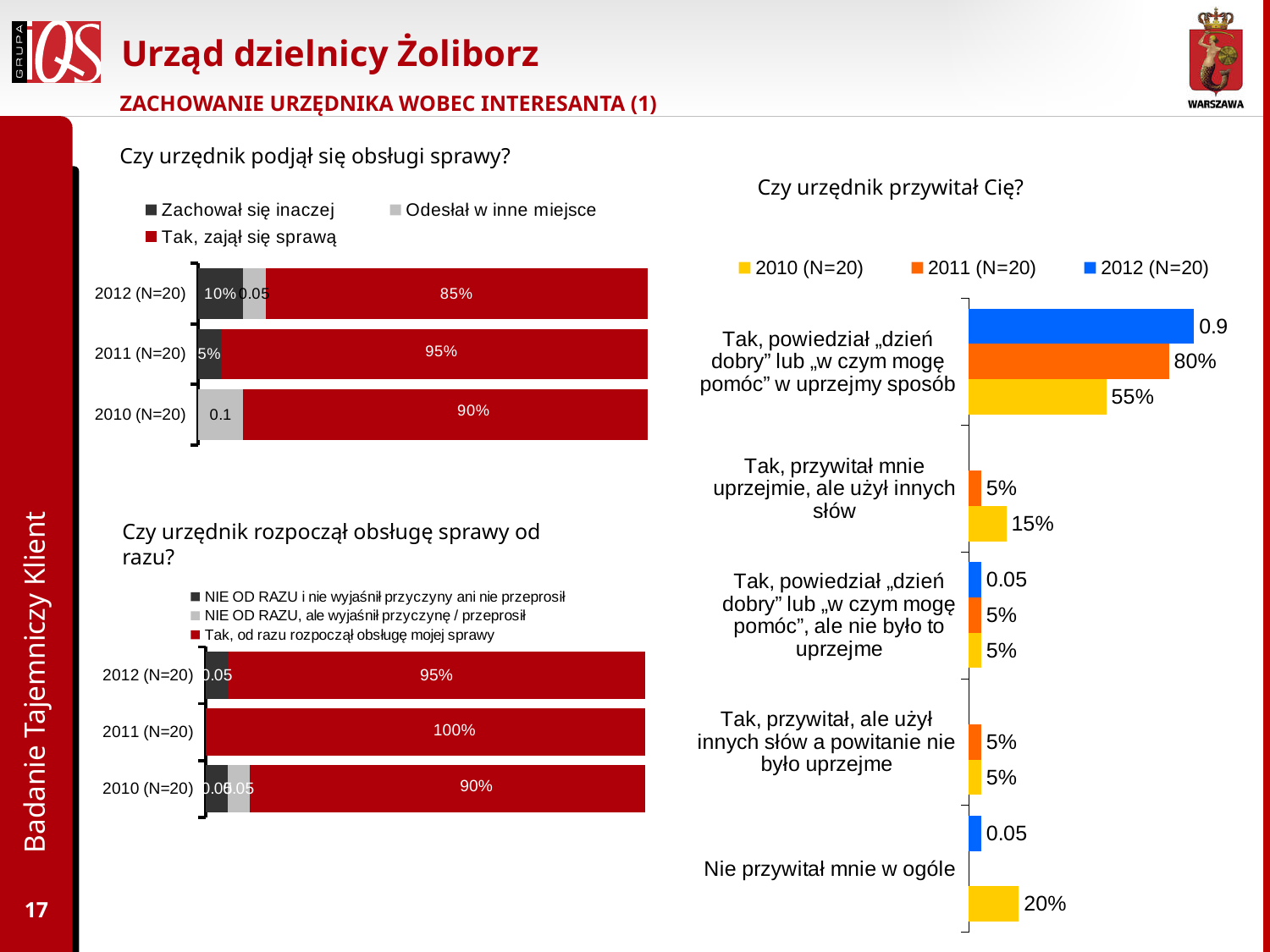
In the chart 'Czy urzędnik przywitał Cię?', is the 2010 (N=20) value for 'Tak, przywitał mnie uprzejmie, ale użył innych słów' larger or smaller than the 2011 (N=20) value? larger In the chart 'Czy urzędnik przywitał Cię?', what is the 2011 (N=20) value for 'Tak, powiedział „dzień dobry” lub „w czym mogę pomóc” w uprzejmy sposób'? 80% In the chart 'Czy urzędnik podjął się obsługi sprawy?', how many series does the legend list? 3 In the chart 'Czy urzędnik przywitał Cię?', what is the 2010 (N=20) value for 'Nie przywitał mnie w ogóle'? 20% In the chart 'Czy urzędnik podjął się obsługi sprawy?', what is the value of 'Tak, zajął się sprawą' for 2012 (N=20)? 85% In the chart 'Czy urzędnik rozpoczął obsługę sprawy od razu?', how many year categories are shown? 3 In the chart 'Czy urzędnik podjął się obsługi sprawy?', what is the value of 'Tak, zajął się sprawą' for 2011 (N=20)? 95% What type of chart is 'Czy urzędnik przywitał Cię?'? bar chart In the chart 'Czy urzędnik podjął się obsługi sprawy?', which year has the highest value for 'Tak, zajął się sprawą'? 2011 (N=20) In the chart 'Czy urzędnik rozpoczął obsługę sprawy od razu?', what is the value of 'Tak, od razu rozpoczął obsługę mojej sprawy' for 2011 (N=20)? 100% In the chart 'Czy urzędnik rozpoczął obsługę sprawy od razu?', what is the difference between the 'Tak, od razu rozpoczął obsługę mojej sprawy' values for 2012 (N=20) and 2010 (N=20)? 5% In the chart 'Czy urzędnik przywitał Cię?', which year has the lowest value for 'Tak, powiedział „dzień dobry” lub „w czym mogę pomóc” w uprzejmy sposób'? 2010 (N=20)